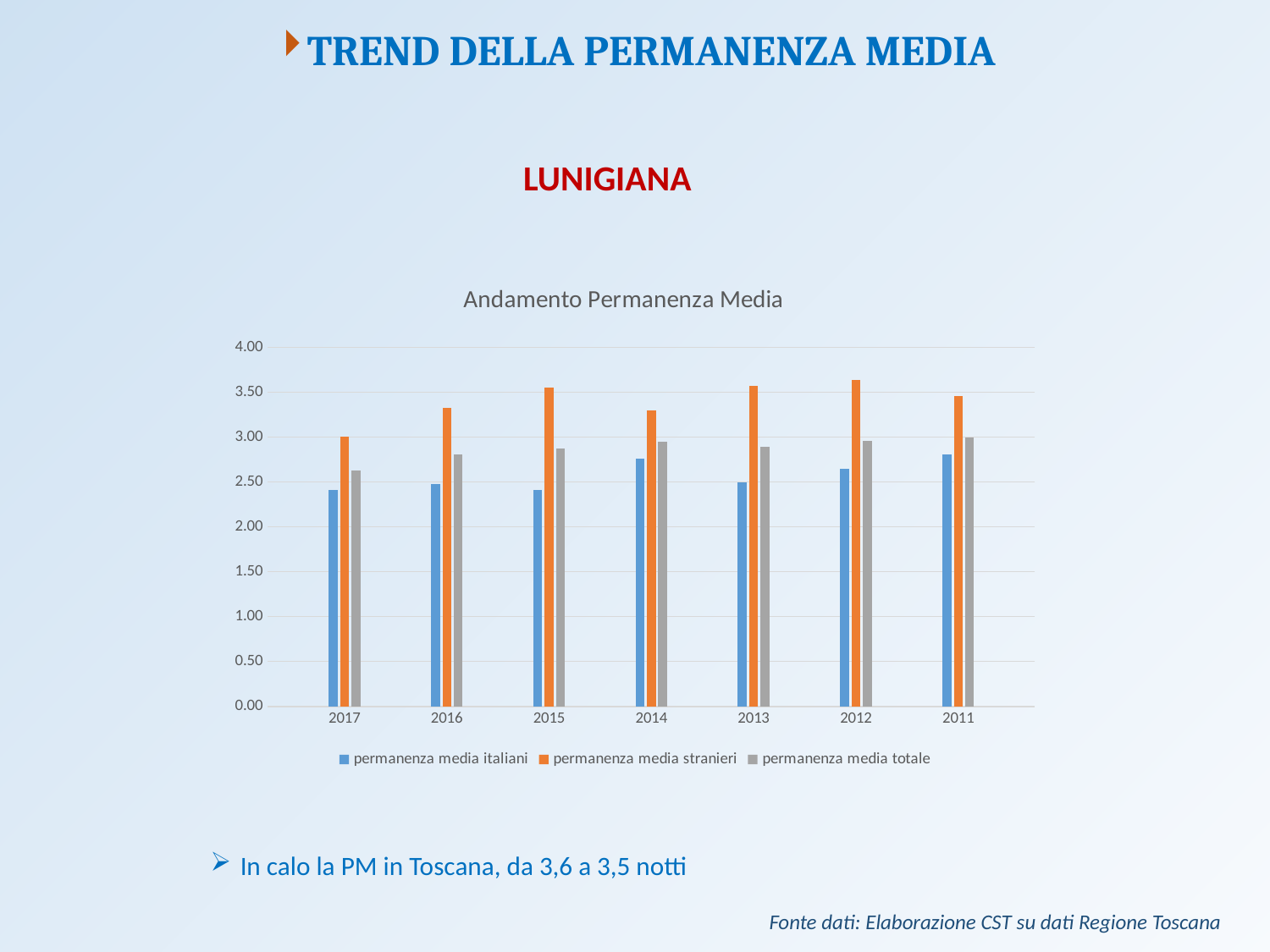
Is the value for permanenza media stranieri in 2012 greater or less than 3.50? greater In which year is the value for permanenza media stranieri lowest? 2017 Is the value for permanenza media italiani in 2017 greater or less than 2.50? less In which year is the value for permanenza media totale lowest? 2017 In 2014, which is larger: permanenza media italiani or permanenza media stranieri? permanenza media stranieri Which is larger: permanenza media totale in 2017 or in 2011? 2011 Is the value for permanenza media stranieri in 2016 greater or less than 3.50? less How many series does the legend list? 3 How many years are shown on the x axis? 7 What is the title of the chart? Andamento Permanenza Media What kind of chart is shown on the slide? bar chart Which series is shown in orange? permanenza media stranieri